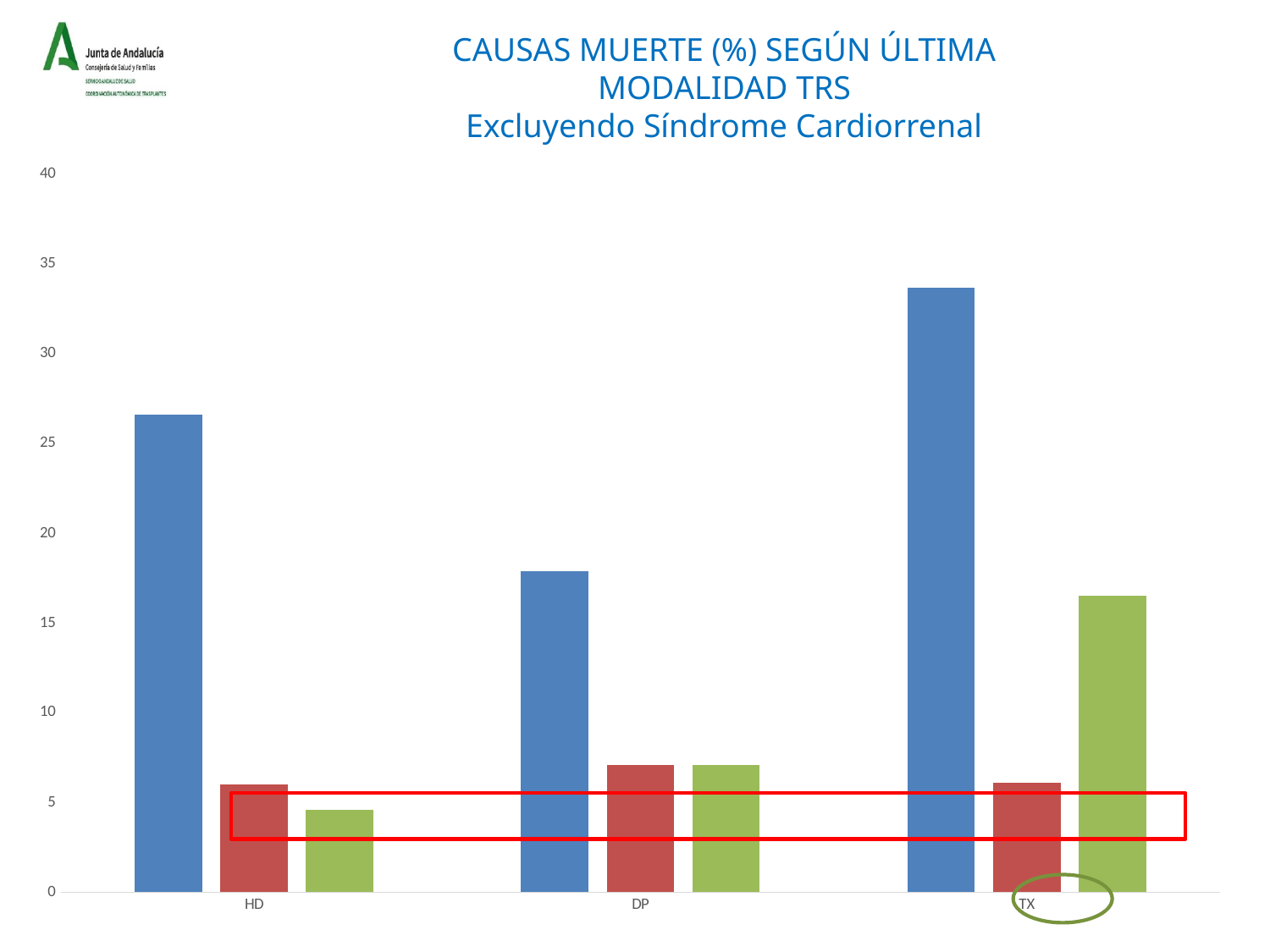
What is the title of the chart? CAUSAS MUERTE (%) SEGÚN ÚLTIMA MODALIDAD TRS Excluyendo Síndrome Cardiorrenal Is the blue bar for HD greater or less than 25? greater Do the green bars rise or fall from HD to TX along the x axis? rise Which category has the shortest green bar? HD Is the green bar for TX greater or less than 15? greater Is the blue bar for TX greater or less than 30? greater What kind of chart is shown on the slide? bar chart How many categories are shown on the x axis of the chart? 3 Which category has the tallest blue bar? TX Which is larger, the blue bar for TX or the blue bar for HD? TX